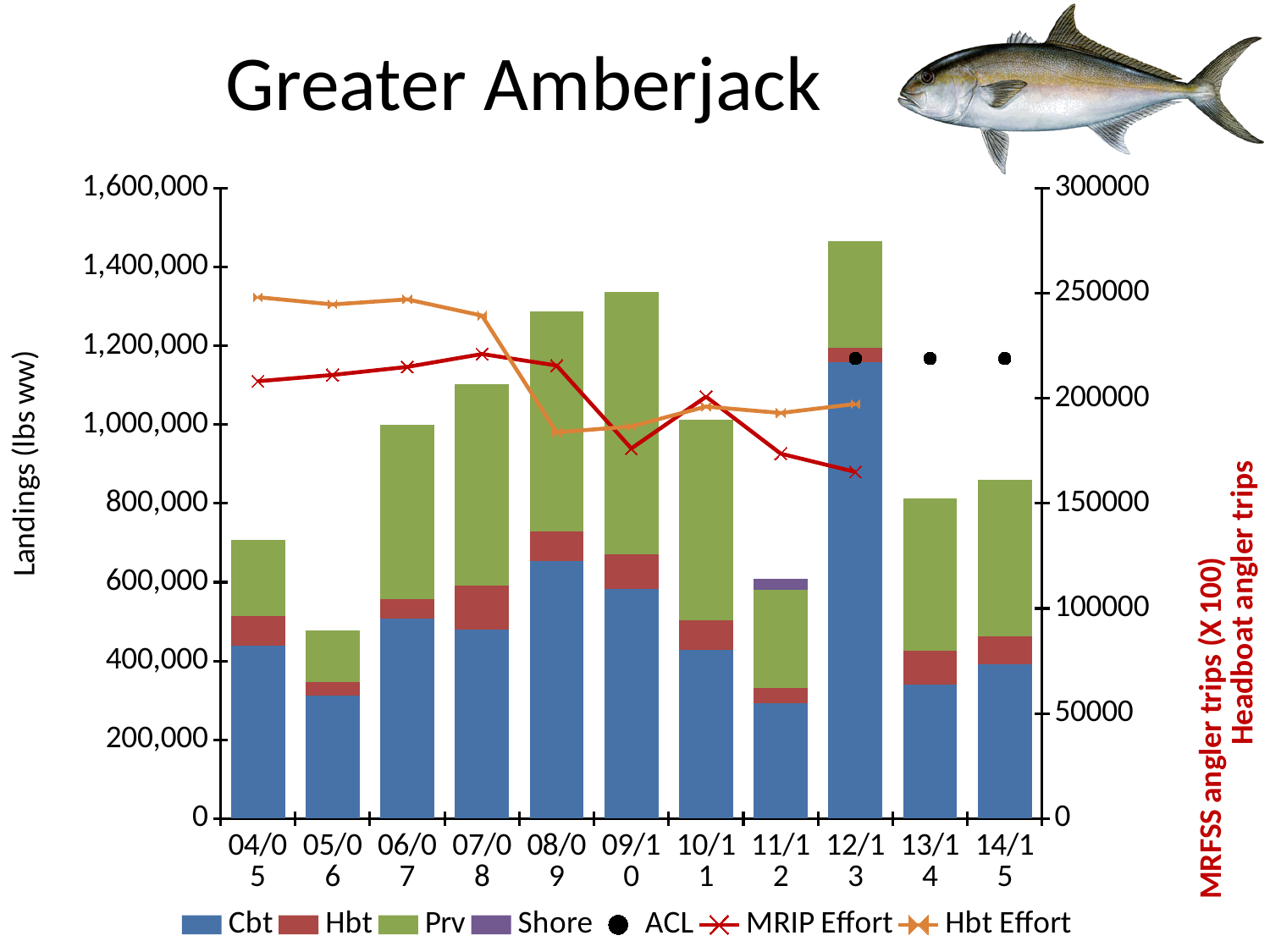
Does the Hbt Effort line generally rise or fall from 04/05 to 12/13? fall Is the total landings bar for 05/06 greater or less than 600,000? less Which fishing year has the highest total landings bar? 12/13 How many series does the legend list? 7 Which has the larger total landings bar, 06/07 or 07/08? 07/08 In which fishing year is the MRIP Effort line at its lowest point? 12/13 How many fishing-year categories are shown on the x axis? 11 Is the total landings bar for 12/13 greater or less than 1,400,000? greater Which fishing year has the lowest total landings bar? 05/06 What kind of chart is shown on the slide? A combination chart of stacked bars and lines Is the total landings bar for 09/10 greater or less than 1,200,000? greater Which fishing year is the only one with a visible Shore segment in its bar? 11/12